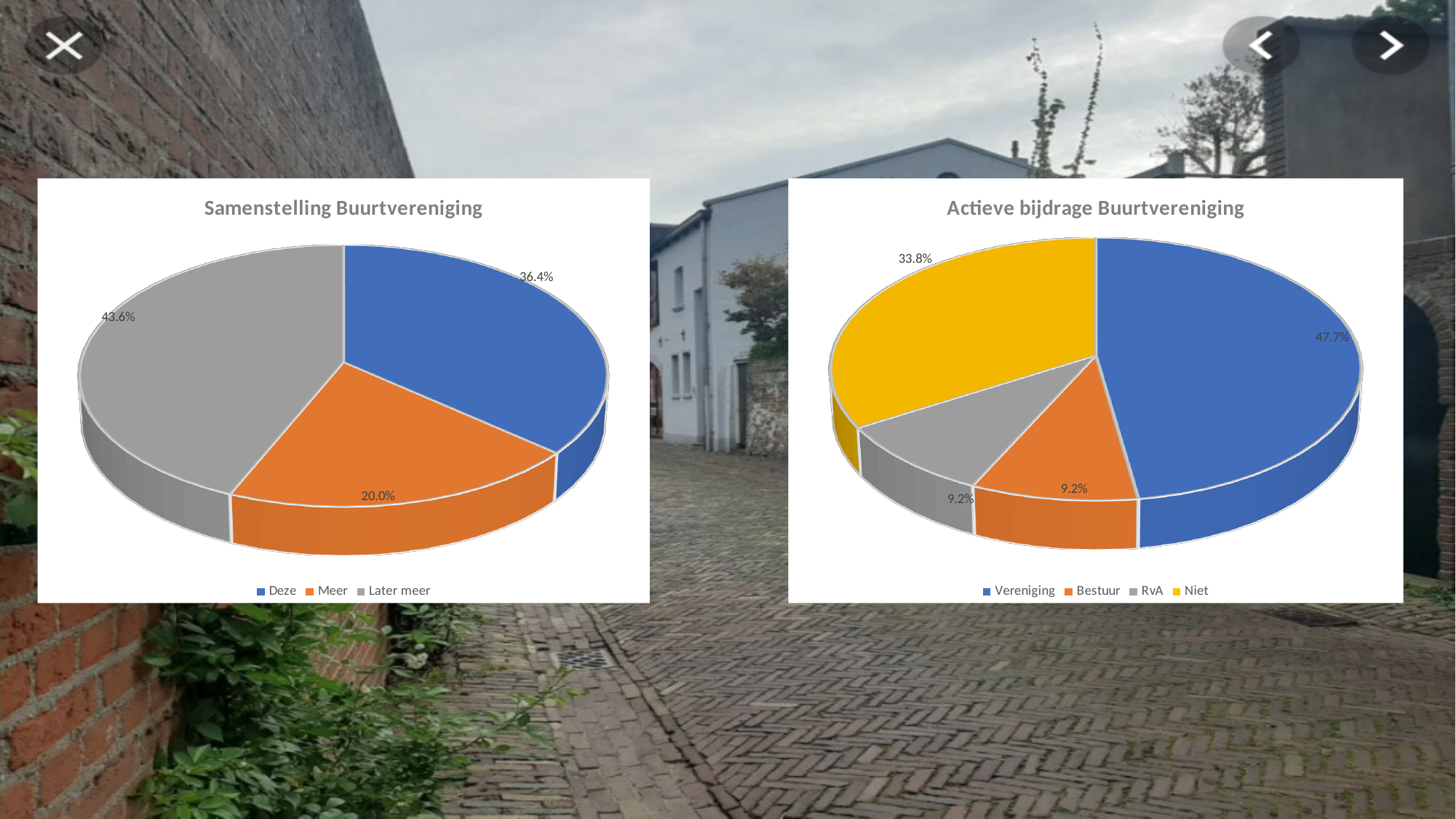
How many categories does the 'Samenstelling Buurtvereniging' chart show? 3 In the 'Actieve bijdrage Buurtvereniging' chart, what is the value for 'Vereniging'? 47.7% How many entries does the legend of the 'Actieve bijdrage Buurtvereniging' chart list? 4 In the 'Samenstelling Buurtvereniging' chart, what is the difference between 'Later meer' and 'Deze'? 7.2% In the 'Samenstelling Buurtvereniging' chart, what is the value for 'Deze'? 36.4% In the 'Actieve bijdrage Buurtvereniging' chart, what share does 'Niet' have? 33.8% In the 'Samenstelling Buurtvereniging' chart, what share does 'Later meer' have? 43.6% In the 'Actieve bijdrage Buurtvereniging' chart, which is larger, 'Niet' or 'Bestuur'? Niet What kind of chart is 'Actieve bijdrage Buurtvereniging'? Pie chart In the 'Actieve bijdrage Buurtvereniging' chart, which category has the largest slice? Vereniging In the 'Samenstelling Buurtvereniging' chart, which category has the largest slice? Later meer In the 'Samenstelling Buurtvereniging' chart, which category has the smallest slice? Meer